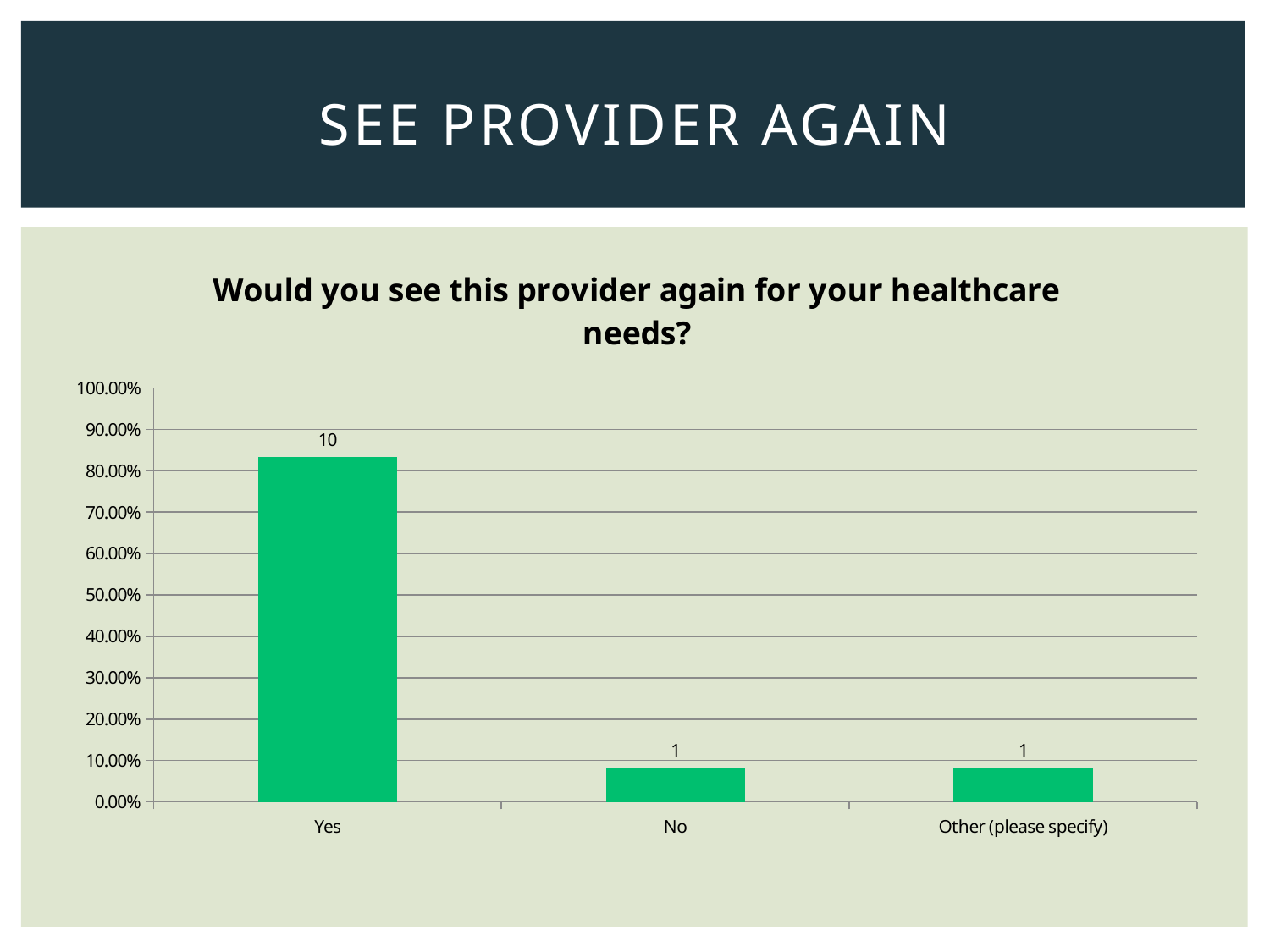
Which is larger, the value for Yes or the value for No? Yes Which category has the highest bar? Yes What is the difference between the data labels for Yes and No? 9 What data label is shown on the bar for Yes? 10 What data label is shown on the bar for Other (please specify)? 1 What data label is shown on the bar for No? 1 Is the bar for No greater or less than 20.00%? less How many categories are shown on the x axis? 3 What kind of chart is shown on the slide? Bar chart What is the title of the chart? Would you see this provider again for your healthcare needs? Is the bar for Yes greater or less than 90.00%? less Is the bar for Yes greater or less than 80.00%? greater